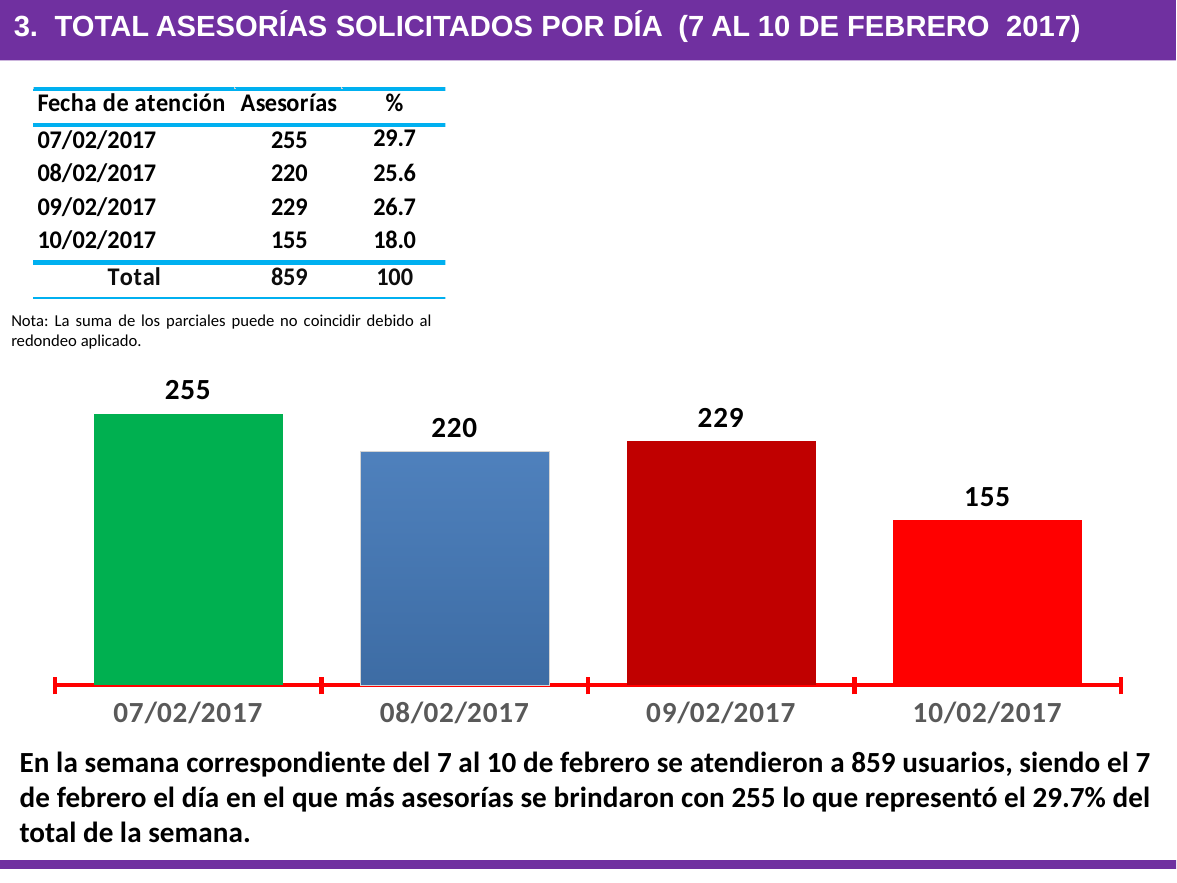
What is the value for 09/02/2017? 229 What is the difference between the values for 09/02/2017 and 08/02/2017? 9 Which date has the lowest value? 10/02/2017 What is the difference between the values for 07/02/2017 and 10/02/2017? 100 What is the value for 07/02/2017? 255 What colour is the bar for 07/02/2017? green What is the value for 08/02/2017? 220 What is the value for 10/02/2017? 155 What kind of chart is shown on the slide? bar chart How many dates are shown on the chart? 4 Which date has the highest value? 07/02/2017 Which is larger, the value for 08/02/2017 or the value for 09/02/2017? 09/02/2017